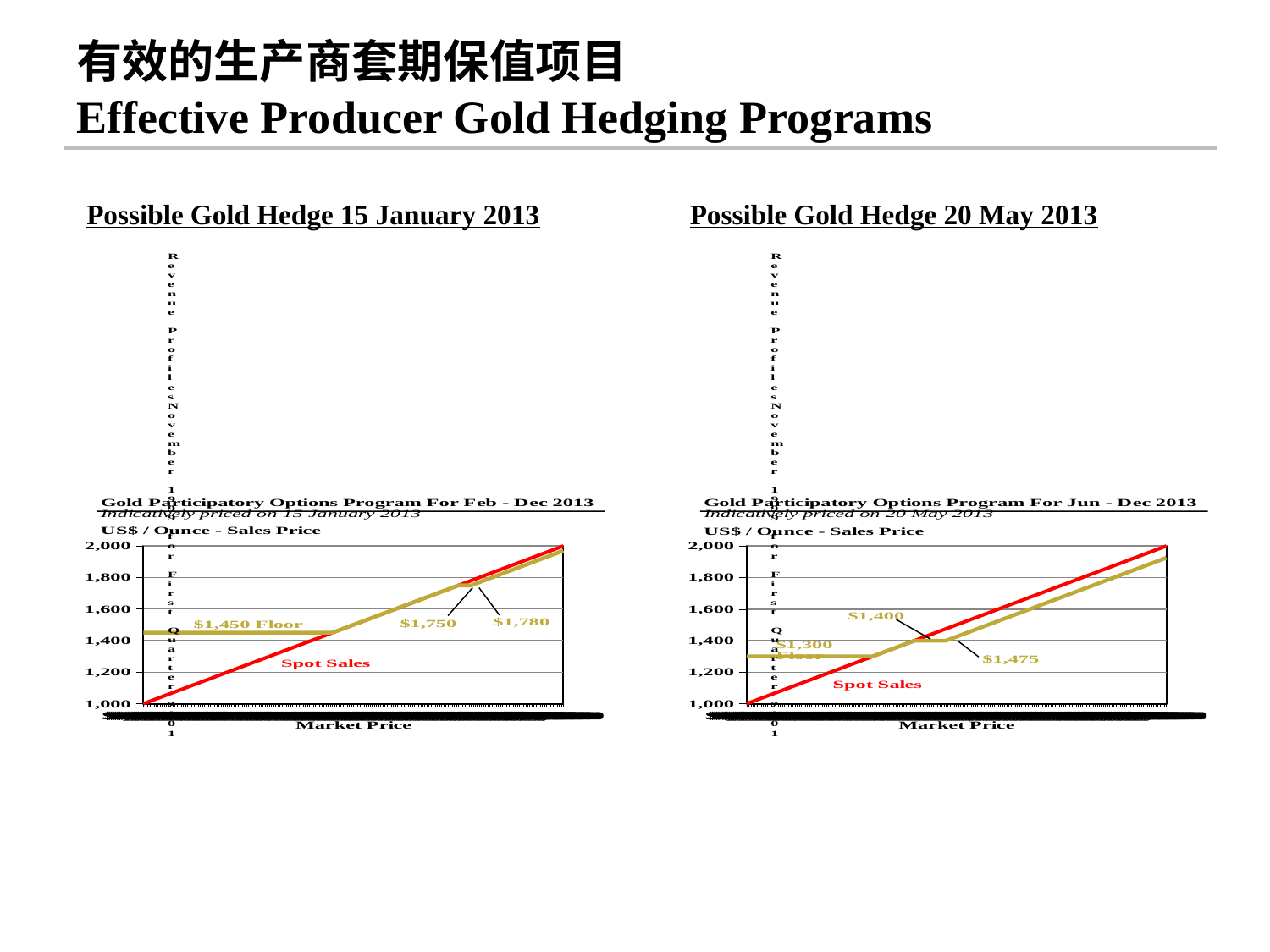
In the 'Possible Gold Hedge 20 May 2013' chart, what is the difference between the $1,475 and $1,400 labelled price levels? $75 What is the highest value shown on the vertical axis of the 'Possible Gold Hedge 15 January 2013' chart? 2,000 In the 'Possible Gold Hedge 15 January 2013' chart, what are the two price levels labelled at the upper kink of the hedged line? $1,750 and $1,780 In the 'Possible Gold Hedge 20 May 2013' chart, what is the highest price level labelled on the hedged line? $1,475 What is the title printed inside the 'Possible Gold Hedge 20 May 2013' chart? Gold Participatory Options Program For Jun - Dec 2013 In the 'Possible Gold Hedge 20 May 2013' chart, what is the lowest price level labelled on the hedged line? $1,300 In the 'Possible Gold Hedge 15 January 2013' chart, what is the floor price labelled on the hedged revenue line? $1,450 Floor In the 'Possible Gold Hedge 15 January 2013' chart, what is the label on the red line? Spot Sales In the 'Possible Gold Hedge 20 May 2013' chart, does the Spot Sales line rise or fall as Market Price increases? rise In the 'Possible Gold Hedge 15 January 2013' chart, what is the difference between the $1,780 and $1,750 labelled price levels? $30 What kind of chart is the 'Possible Gold Hedge 15 January 2013' chart? line chart Which chart shows the higher floor price: the 15 January 2013 chart ($1,450) or the 20 May 2013 chart ($1,300)? 15 January 2013 chart